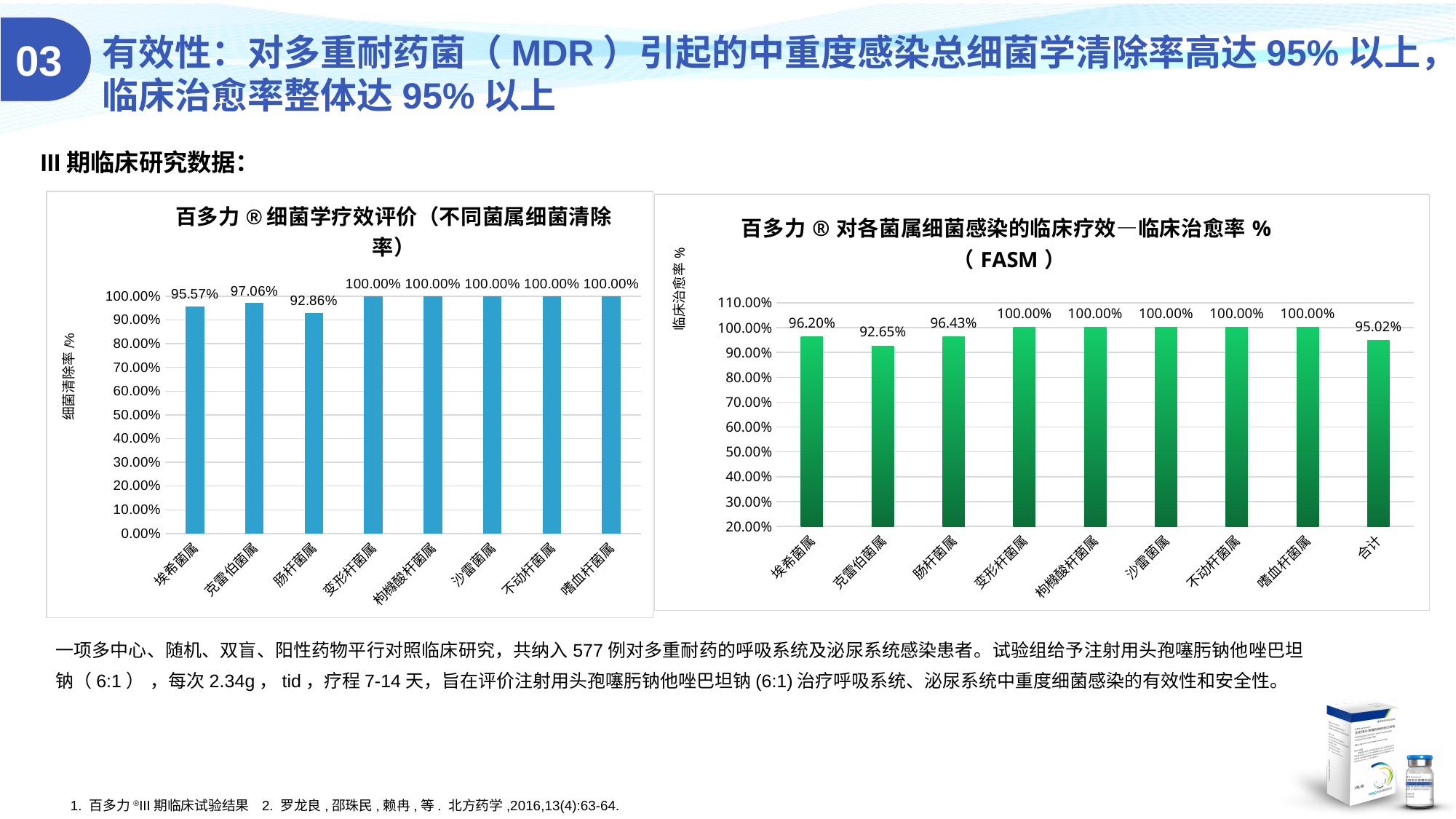
In the left chart (百多力®细菌学疗效评价), what is the value for 克雷伯菌属? 97.06% In the left chart (百多力®细菌学疗效评价), how many categories are plotted? 8 In the left chart (百多力®细菌学疗效评价), what is the difference between the values for 克雷伯菌属 and 埃希菌属? 1.49% In the right chart (临床治愈率 FASM), what is the value for 肠杆菌属? 96.43% In the left chart (百多力®细菌学疗效评价), what is the y-axis label? 细菌清除率 /% In the right chart (临床治愈率 FASM), which category has the lowest value? 克雷伯菌属 In the right chart (临床治愈率 FASM), what is the difference between the values for 变形杆菌属 and 合计? 4.98% In the right chart (临床治愈率 FASM), what is the value for 合计? 95.02% In the left chart (百多力®细菌学疗效评价), which category has the lowest value? 肠杆菌属 In the right chart (临床治愈率 FASM), how many categories are plotted? 9 In the right chart (临床治愈率 FASM), which is larger, the value for 埃希菌属 or 克雷伯菌属? 埃希菌属 In the left chart (百多力®细菌学疗效评价), what kind of chart is it? Bar chart